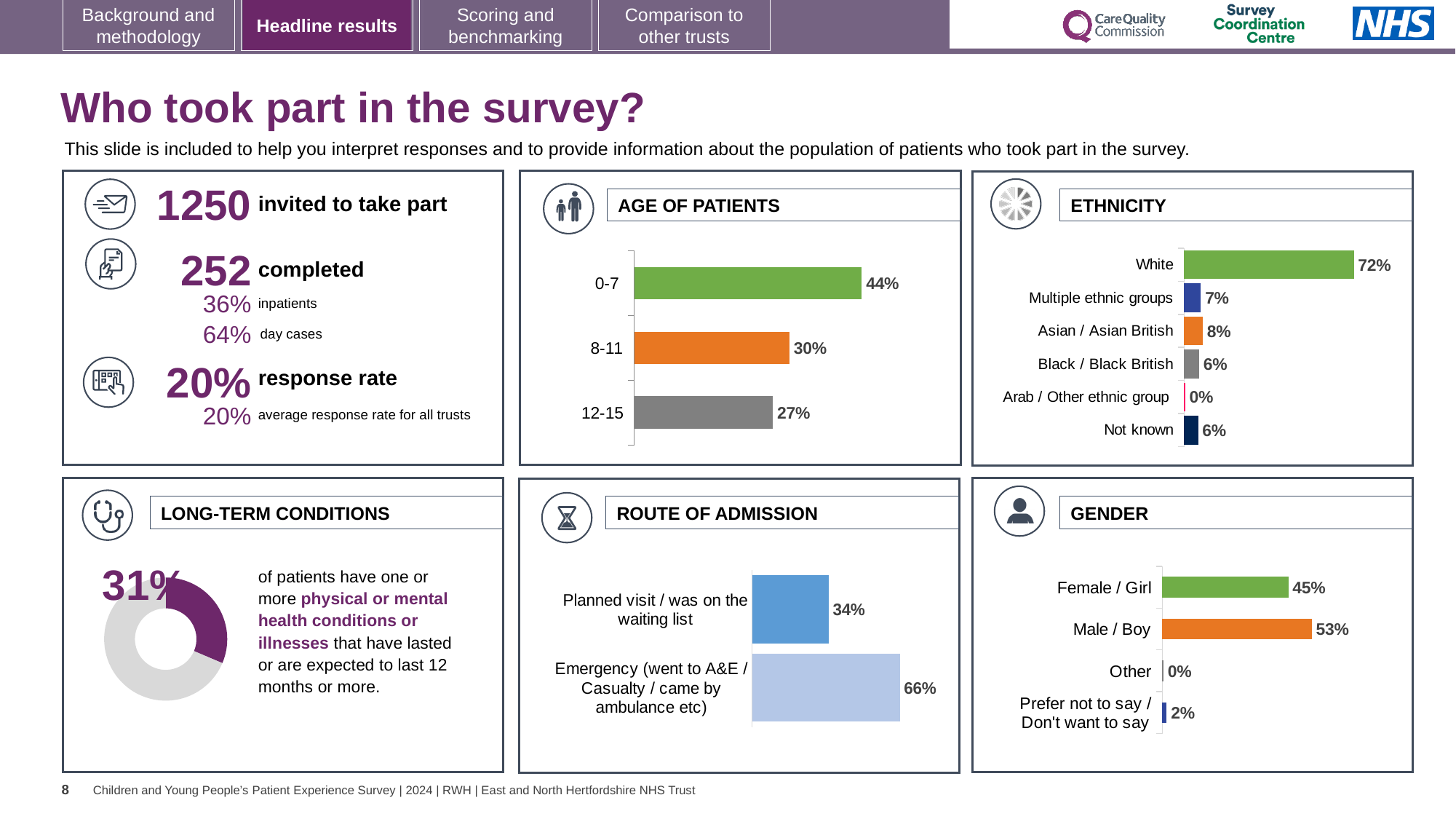
In the ROUTE OF ADMISSION chart, which route has the larger value: Planned visit / was on the waiting list or Emergency? Emergency (went to A&E / Casualty / came by ambulance etc) In the ETHNICITY chart, what is the value for Asian / Asian British? 8% In the ROUTE OF ADMISSION chart, what percentage of patients came via Emergency (went to A&E / Casualty / came by ambulance etc)? 66% In the ETHNICITY chart, how many categories are shown? 6 In the GENDER chart, what is the value for Male / Boy? 53% In the LONG-TERM CONDITIONS chart, what share of patients have one or more physical or mental health conditions or illnesses? 31% In the ETHNICITY chart, which category has the highest value? White In the GENDER chart, what is the difference between the values for Male / Boy and Female / Girl? 8% What kind of chart is used in the AGE OF PATIENTS panel? Bar chart In the AGE OF PATIENTS chart, what percentage of patients were aged 0-7? 44% In the AGE OF PATIENTS chart, which age group has the lowest percentage? 12-15 In the ETHNICITY chart, what is the difference between the values for White and Multiple ethnic groups? 65%